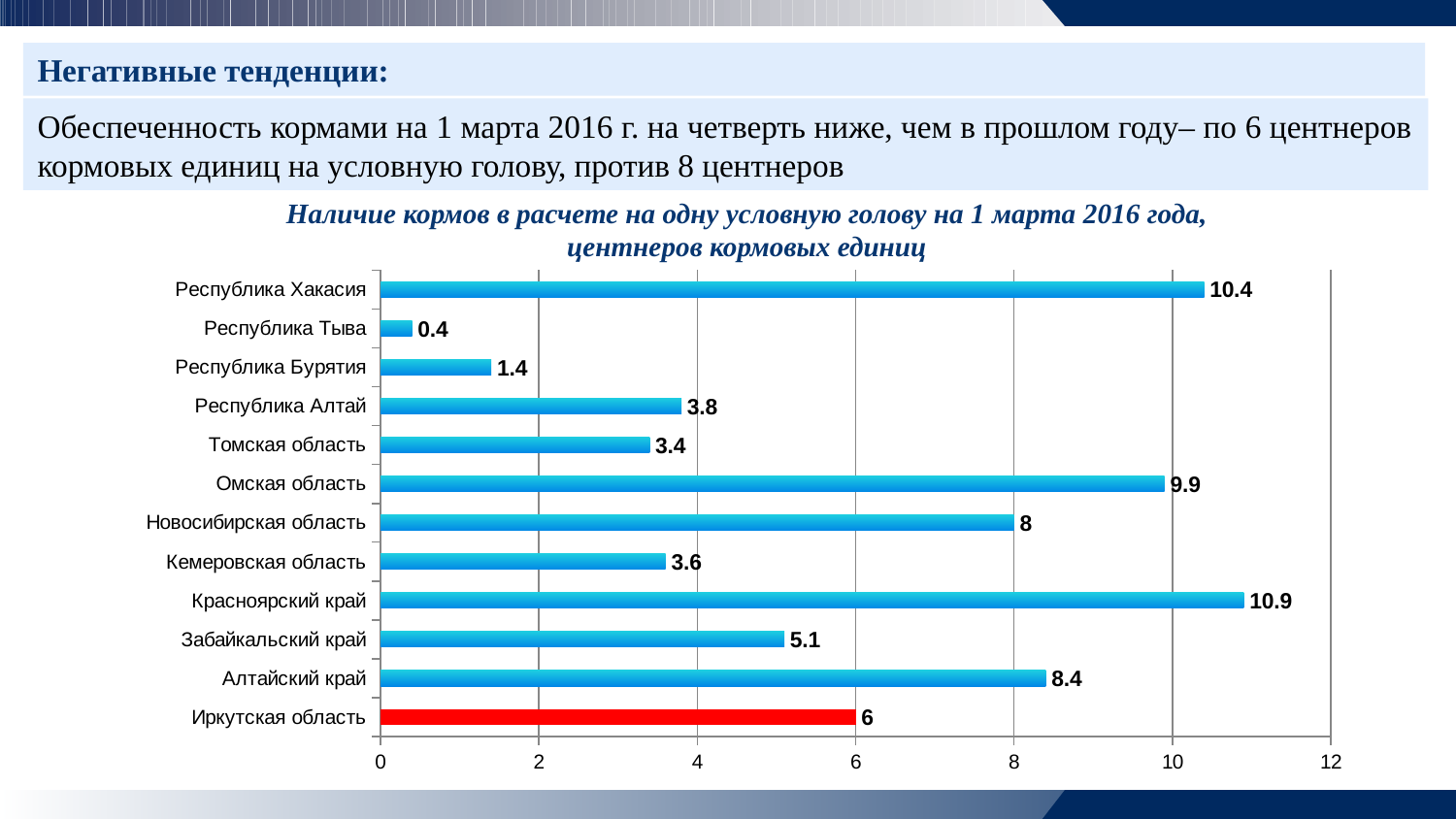
Which is larger, the value for Алтайский край or the value for Новосибирская область? Алтайский край What is the value for Забайкальский край? 5.1 What kind of chart is shown on the slide? Bar chart Which is larger, the value for Томская область or the value for Кемеровская область? Кемеровская область Which region has the lowest value? Республика Тыва How many regions are shown in the chart? 12 Which region has the highest value? Красноярский край What is the difference between the values for Омская область and Новосибирская область? 1.9 What is the value for Иркутская область? 6 Which region's bar is coloured red? Иркутская область What is the value for Республика Хакасия? 10.4 What is the difference between the values for Красноярский край and Иркутская область? 4.9